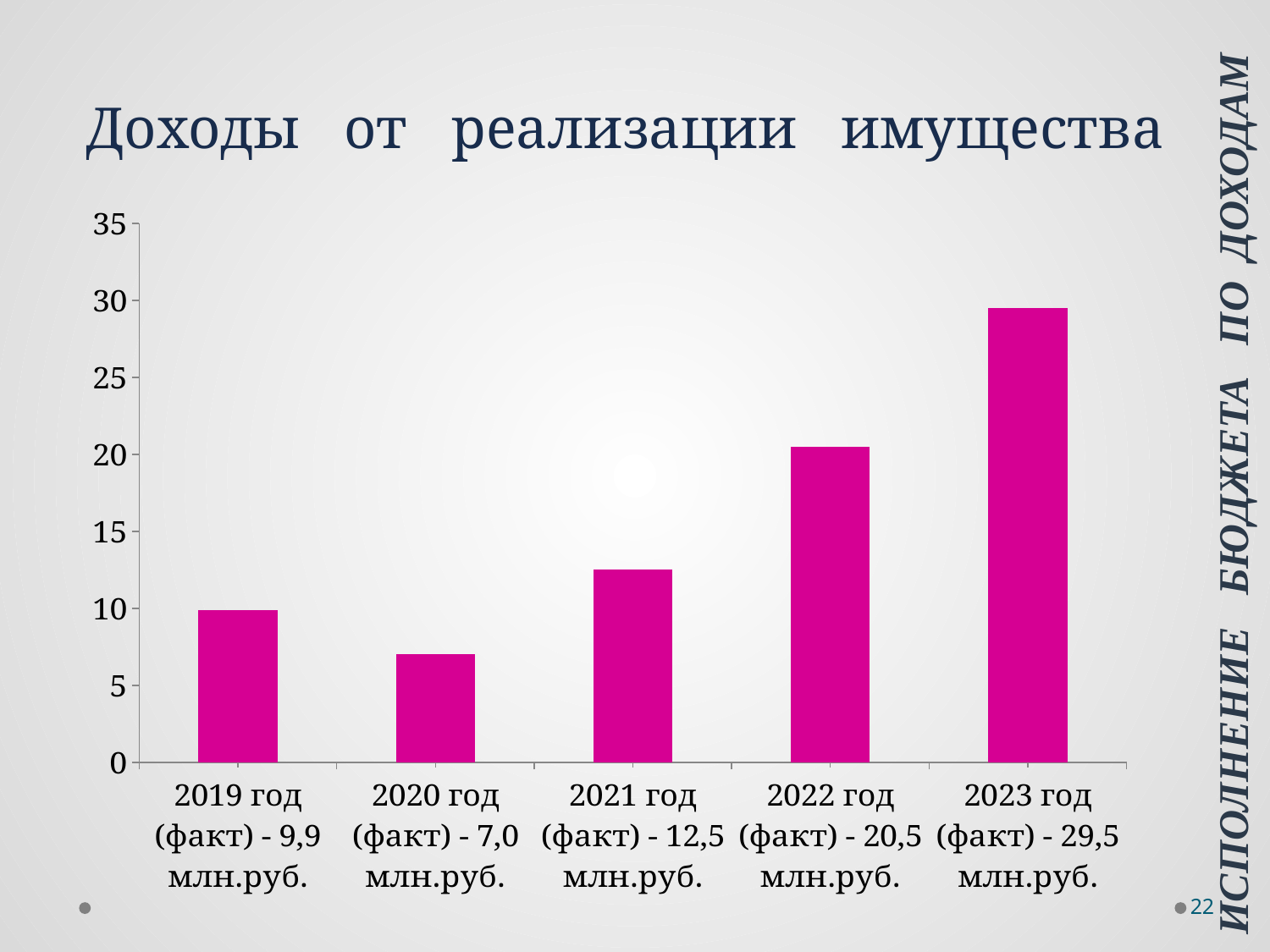
What is the value for 2021 год (факт)? 12,5 млн.руб. What kind of chart is shown on the slide? bar chart How many years are shown on the chart? 5 What is the difference between the values for 2021 год and 2020 год? 5,5 млн.руб. Is the value for 2022 год greater or less than 20? greater Which year has the lowest value? 2020 год Which year has the highest value? 2023 год What is the value for 2019 год (факт)? 9,9 млн.руб. What is the difference between the values for 2023 год and 2022 год? 9,0 млн.руб. What is the value for 2023 год (факт)? 29,5 млн.руб. What is the title of the chart? Доходы от реализации имущества Which is larger, the value for 2019 год or the value for 2020 год? 2019 год